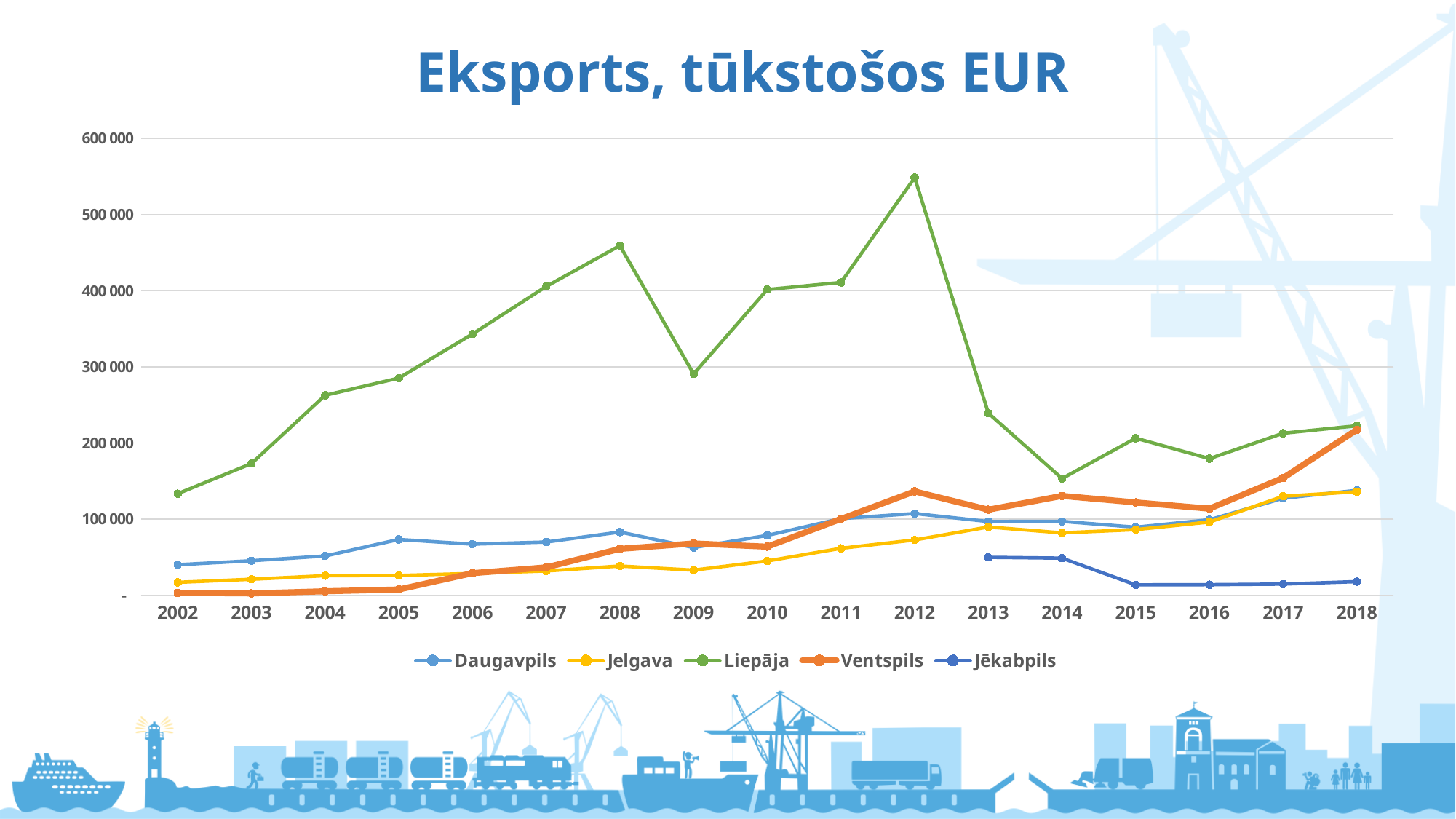
Which city has the lowest export value in 2002? Ventspils How many series does the legend list? 5 Is the value for Liepāja in 2014 greater or less than 200 000? less Which is larger in 2018, the value for Ventspils or the value for Jelgava? Ventspils What kind of chart is shown on the slide? line chart Does the Jēkabpils line rise or fall from 2013 to 2018? fall Which city has the highest export value in 2012? Liepāja How many years are shown on the x axis? 17 Is the value for Ventspils in 2008 greater or less than 100 000? less In which year does the Liepāja line reach its highest point? 2012 Which is larger in 2008, the value for Daugavpils or the value for Jelgava? Daugavpils Is the value for Liepāja in 2012 greater or less than 500 000? greater